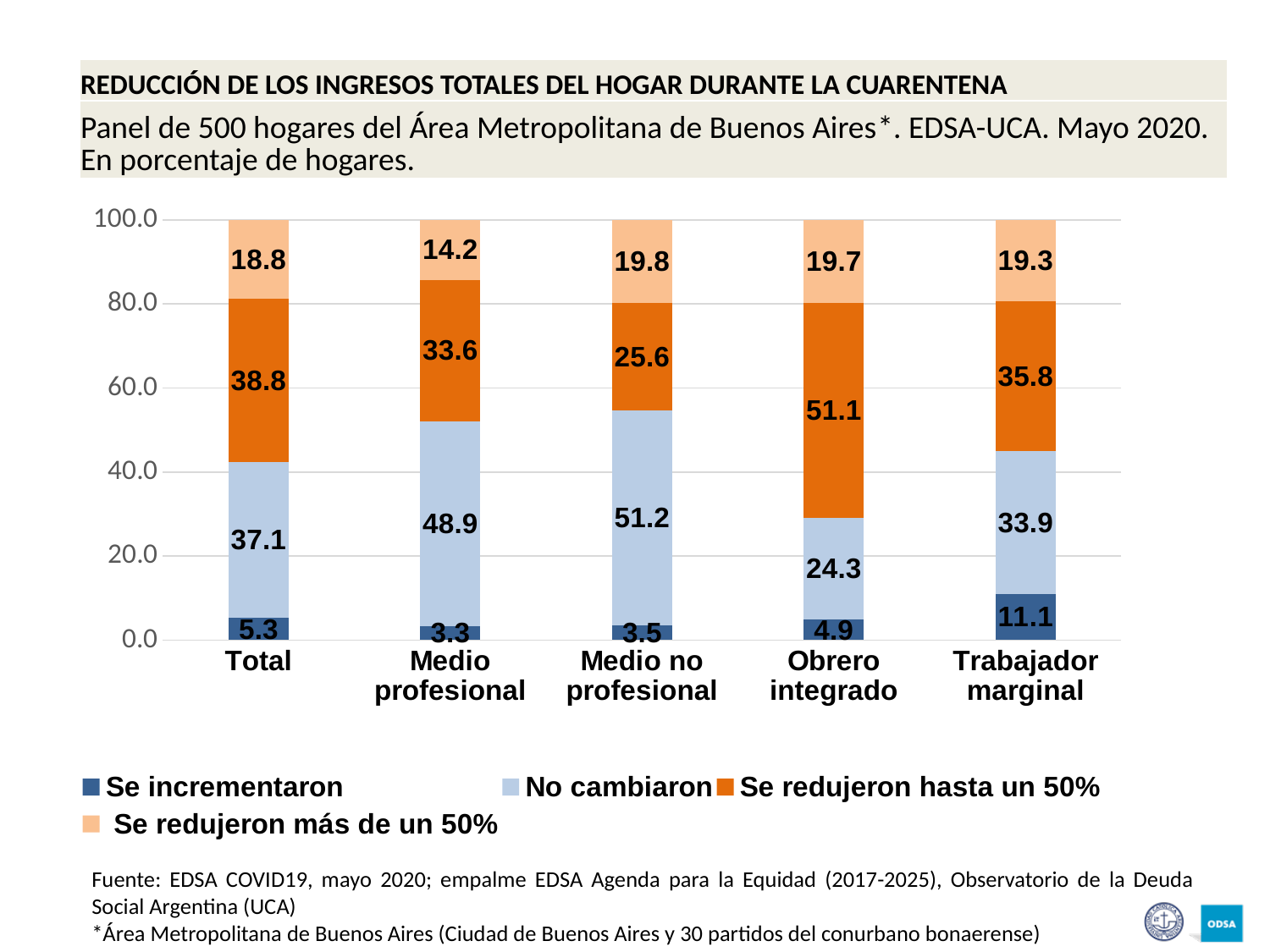
What kind of chart is shown on the slide? Stacked bar chart What is the value of 'No cambiaron' for Medio profesional? 48.9 What is the total of the stacked bar for Total? 100.0 Which category has the highest value for 'No cambiaron'? Medio no profesional Which is larger, the 'Se incrementaron' value for Total or for Obrero integrado? Total How many series does the legend list? 4 What colour represents 'Se redujeron hasta un 50%' in the legend? Orange How many categories are shown on the x axis? 5 Which category has the lowest value for 'Se redujeron más de un 50%'? Medio profesional What is the difference between the 'Se redujeron hasta un 50%' values for Obrero integrado and Medio no profesional? 25.5 What is the value of 'Se redujeron hasta un 50%' for Obrero integrado? 51.1 What is the value of 'Se incrementaron' for Trabajador marginal? 11.1